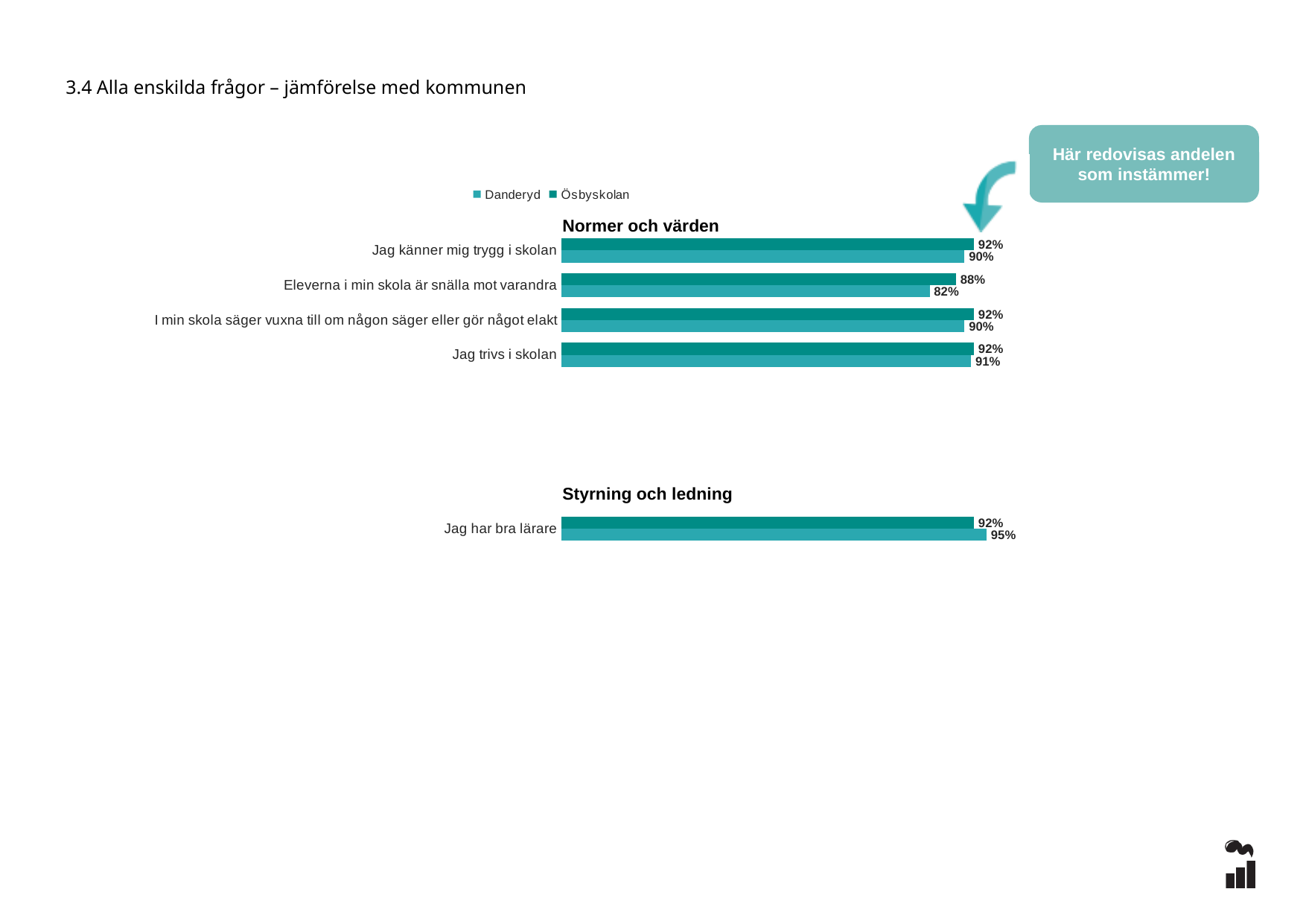
How many series does the legend list? 2 In the 'Normer och värden' chart, which category has the lowest Danderyd value? Eleverna i min skola är snälla mot varandra In the 'Normer och värden' chart, what is the Danderyd value for 'Jag trivs i skolan'? 91% In the 'Normer och värden' chart, what is the difference between the Ösbyskolan and Danderyd values for 'Eleverna i min skola är snälla mot varandra'? 6 percentage points In the 'Normer och värden' chart, what is the Ösbyskolan value for 'Eleverna i min skola är snälla mot varandra'? 88% In the 'Styrning och ledning' chart, which is larger for 'Jag har bra lärare': Danderyd or Ösbyskolan? Danderyd In the 'Styrning och ledning' chart, what is the Danderyd value for 'Jag har bra lärare'? 95% What kind of chart is the 'Normer och värden' chart? Bar chart How many categories are shown in the 'Normer och värden' chart? 4 In the 'Normer och värden' chart, what is the Danderyd value for 'Eleverna i min skola är snälla mot varandra'? 82% What are the two series named in the legend? Danderyd and Ösbyskolan In the 'Styrning och ledning' chart, what is the Ösbyskolan value for 'Jag har bra lärare'? 92%